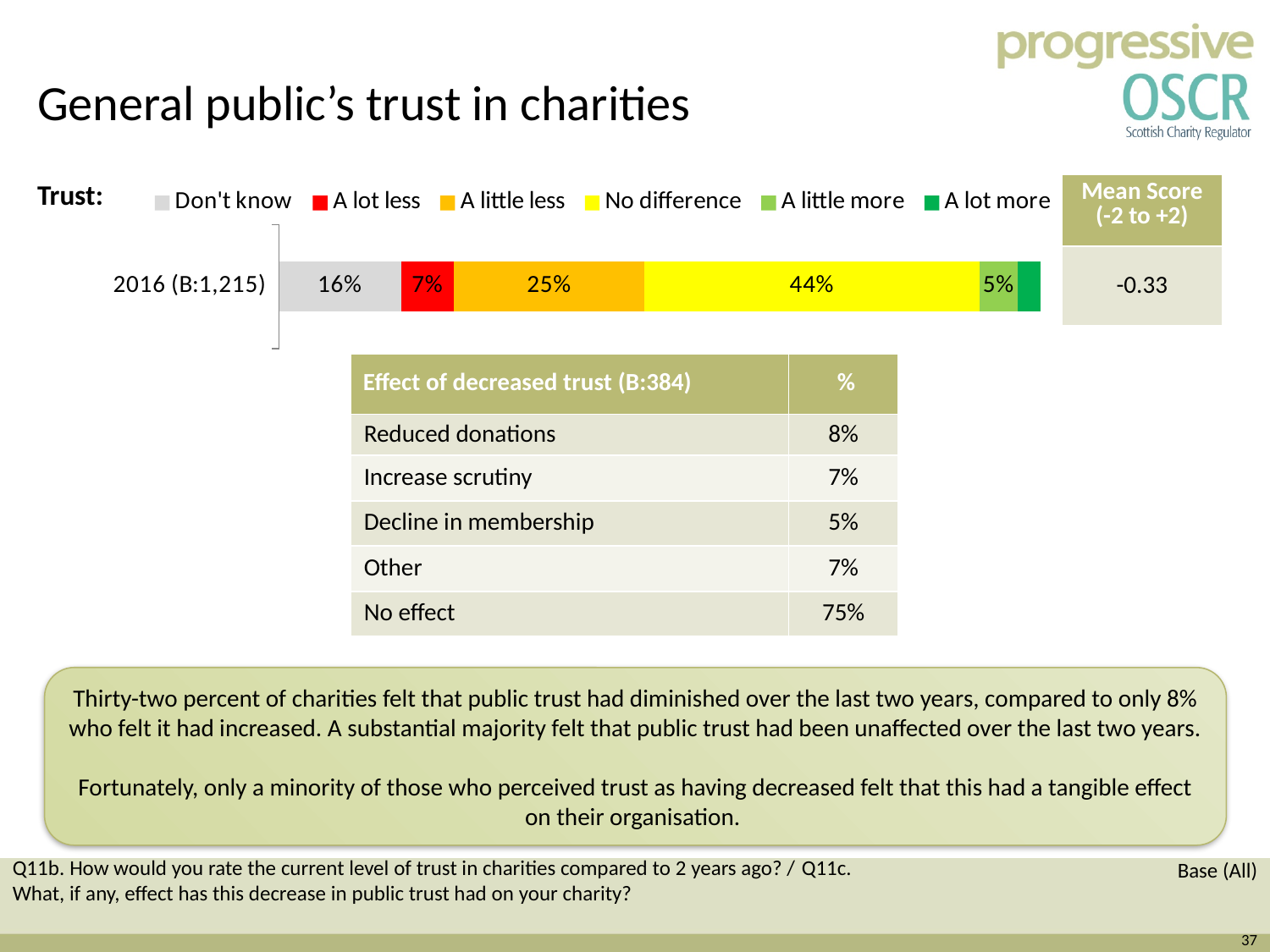
In the stacked bar chart, what percentage is shown for 'No difference' in 2016? 44% In the stacked bar chart, what percentage is shown for 'A little more'? 5% In the stacked bar chart, what percentage is shown for 'A little less'? 25% How many series does the legend of the stacked bar chart list? 6 What is the label of the single bar shown in the stacked bar chart? 2016 (B:1,215) In the stacked bar chart, which is larger: 'Don't know' or 'A little more'? Don't know In the stacked bar chart, what percentage is shown for 'A lot less'? 7% In the stacked bar chart, what percentage is shown for 'Don't know'? 16% What is the difference between the 'A little less' and 'A lot less' percentages in the stacked bar chart? 18% Which response category has the smallest segment in the stacked bar chart? A lot more What kind of chart is used to show the trust ratings? Stacked bar chart Which response category has the largest segment in the stacked bar chart? No difference